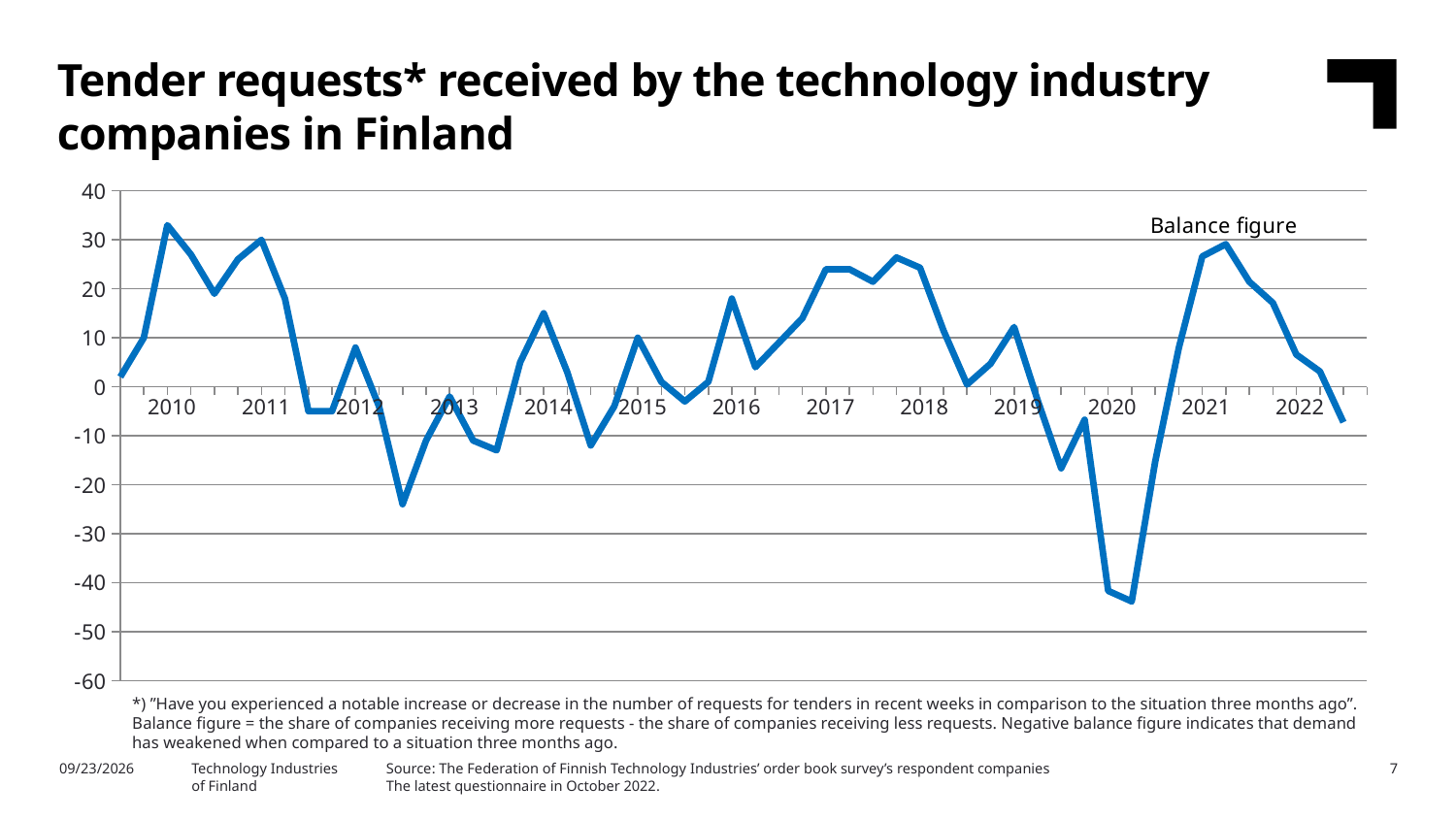
How many year labels are shown along the x axis of the chart? 13 Is the lowest value of the balance figure in 2020 greater or less than -30? less What is the lowest value shown on the y axis of the chart? -60 Is the peak value of the balance figure in 2021 greater or less than 20? greater How many series does the chart's legend list? 1 What kind of chart is shown on the slide? line chart Does the balance figure rise or fall from its 2021 peak to the end of 2022? fall Is the last plotted value of the balance figure in 2022 greater or less than 0? less What is the name of the series shown in the chart's legend? Balance figure Does the balance figure rise or fall from its low point in 2020 to its peak in 2021? rise In which year does the balance figure reach its lowest point? 2020